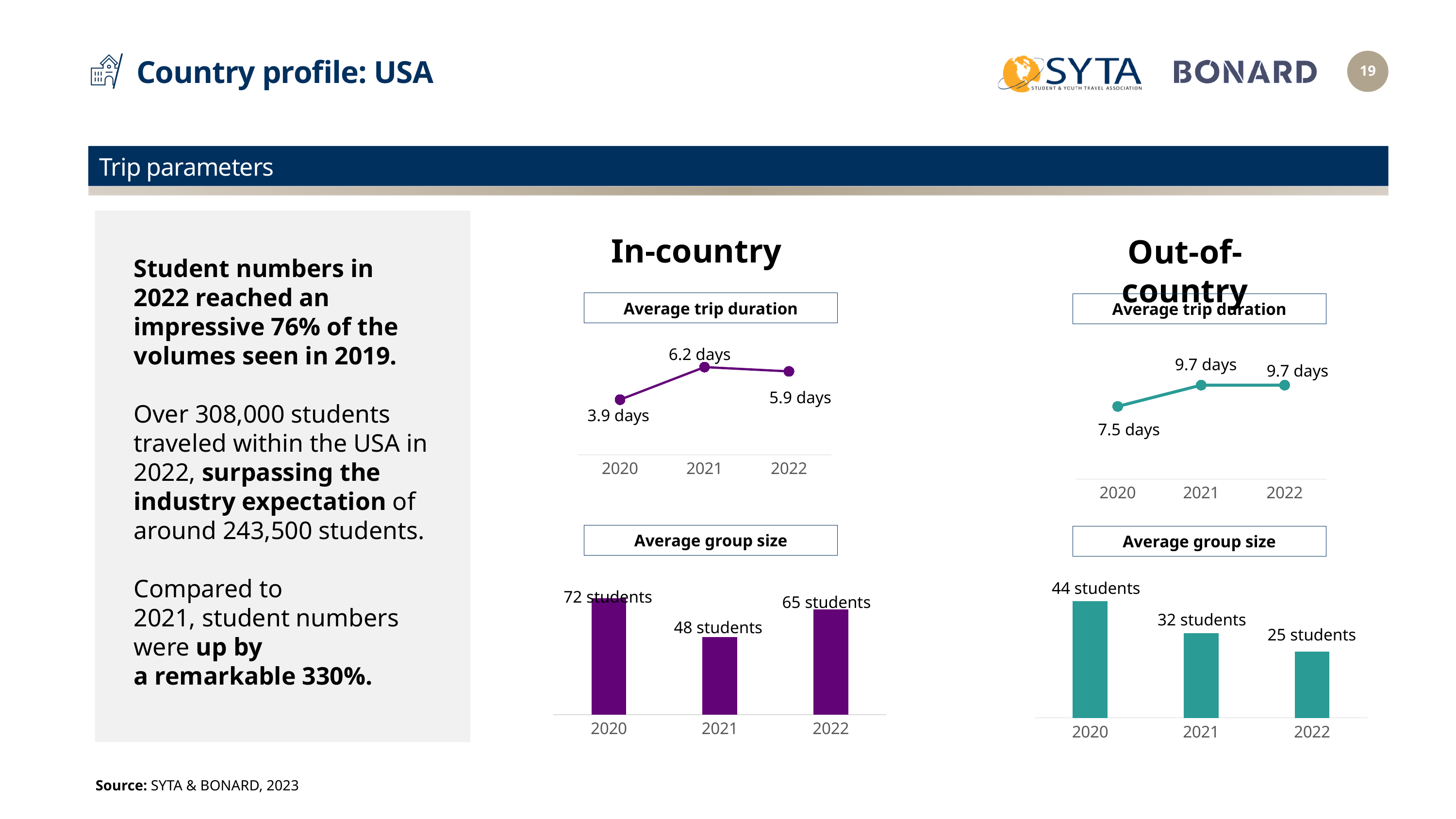
In the Out-of-country Average trip duration chart, what was the average trip duration in 2020? 7.5 days In the Out-of-country Average trip duration chart, what kind of chart is shown? Line chart In the Out-of-country Average group size chart, what was the average group size in 2021? 32 students Which is larger: the In-country average trip duration in 2022 or the Out-of-country average trip duration in 2022? Out-of-country In the In-country Average group size chart, what kind of chart is shown? Bar chart In the In-country Average trip duration chart, which year had the lowest average trip duration? 2020 In the In-country Average group size chart, what was the average group size in 2022? 65 students In the Out-of-country Average group size chart, how many years are shown? 3 In the In-country Average trip duration chart, what was the average trip duration in 2021? 6.2 days In the In-country Average group size chart, what is the difference between the 2020 and 2021 average group sizes? 24 students In the In-country Average group size chart, which year had the highest average group size? 2020 In the Out-of-country Average group size chart, do the values rise or fall from 2020 to 2022? Fall